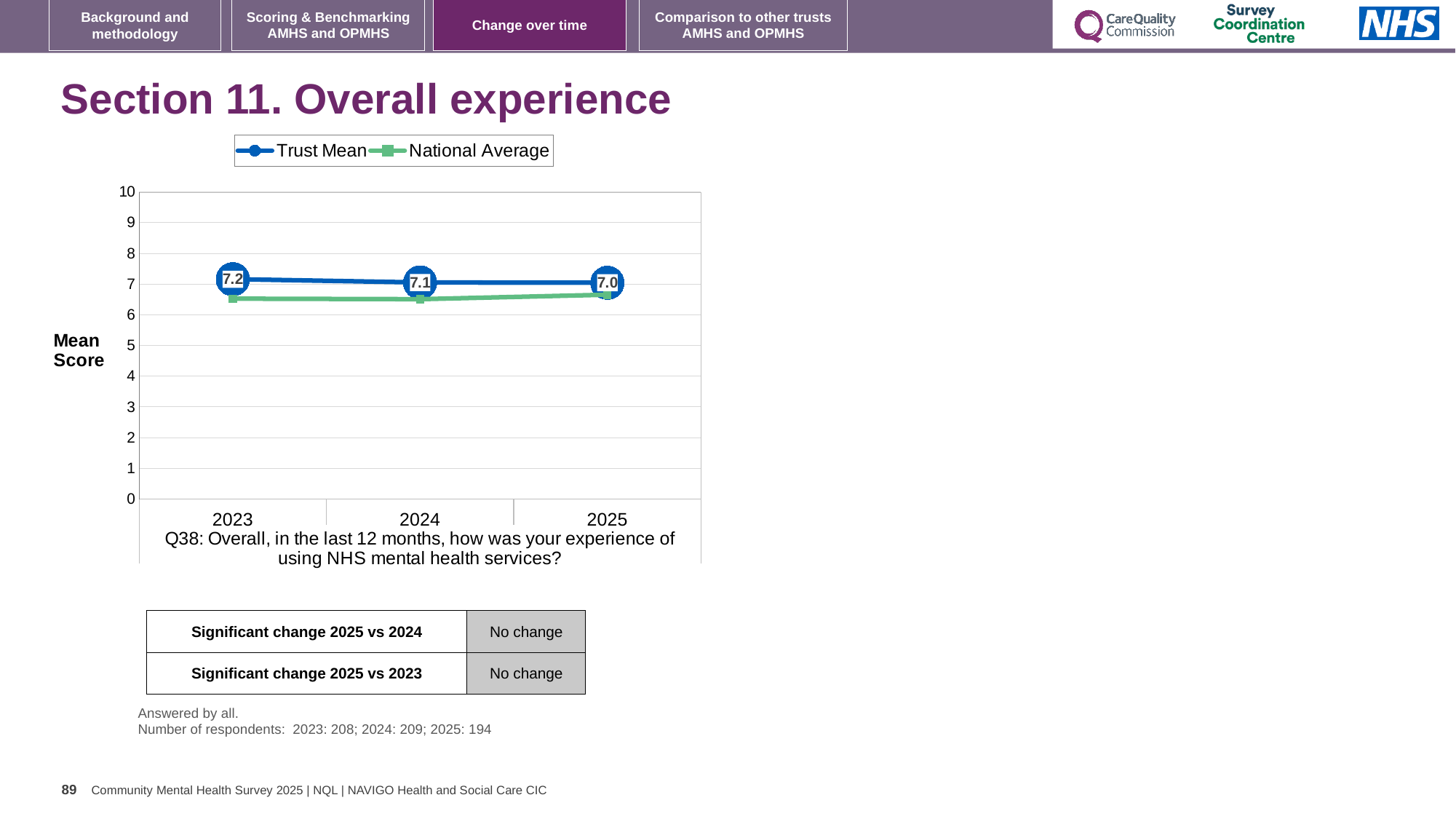
Is the National Average value for 2024 greater or less than 7? less In 2023, which is larger, the Trust Mean or the National Average? Trust Mean How many years are shown on the x axis of the chart? 3 In which year is the Trust Mean lowest? 2025 In which year is the Trust Mean highest? 2023 What is the Trust Mean value for 2025? 7.0 What is the difference between the Trust Mean in 2023 and in 2025? 0.2 What is the Trust Mean value for 2023? 7.2 What kind of chart is shown on the slide? Line chart Is the National Average value for 2025 greater or less than 6? greater How many series does the chart legend list? 2 What is the Trust Mean value for 2024? 7.1